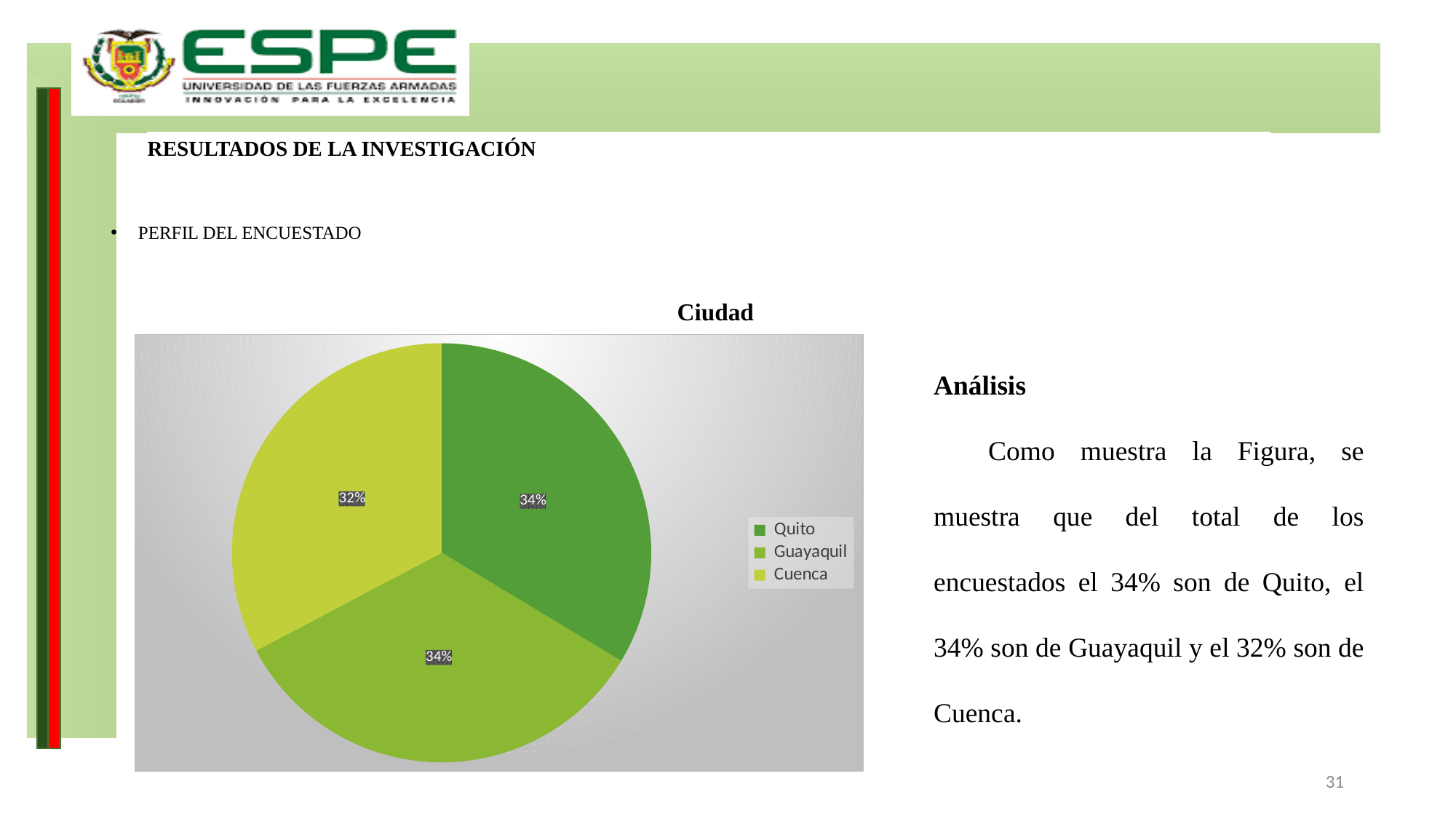
What share of the pie does Cuenca represent? 32% What is the title of the chart? Ciudad Which legend entry is shown in the lightest green colour? Cuenca Which slice is larger, Quito or Cuenca? Quito Which city has the smallest slice of the pie? Cuenca How many slices does the pie chart have? 3 What type of chart is shown on the slide? Pie chart What percentage of respondents are from Quito? 34% What is the difference in percentage points between the Quito slice and the Cuenca slice? 2 percentage points What percentage of respondents are from Guayaquil? 34% What percentage of respondents are from Cuenca? 32% How many entries does the legend list? 3